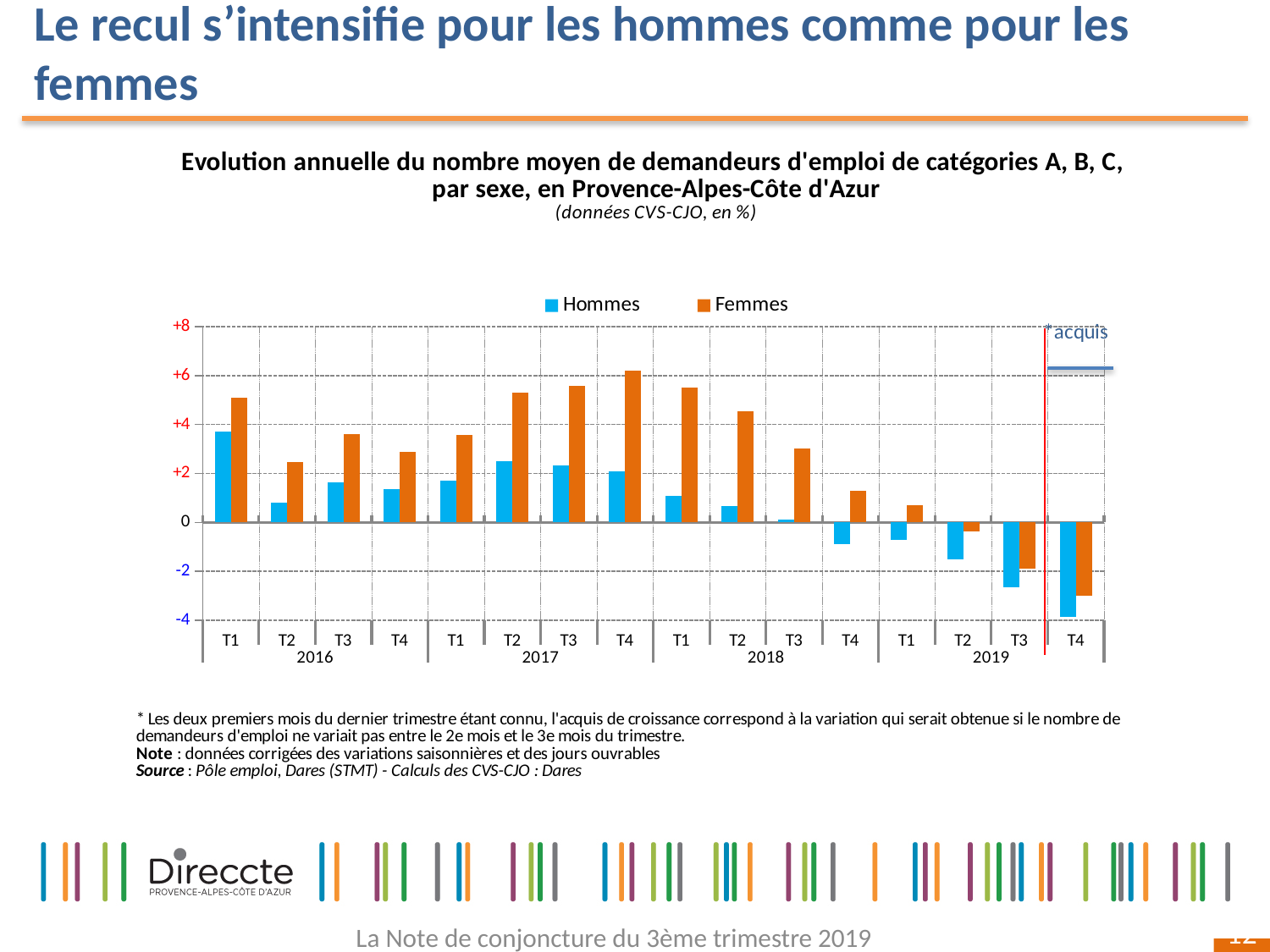
Is the Hommes value for T4 2019 greater or less than -2? less In which quarter is the Femmes value highest? T4 2017 Is the Femmes value for T2 2018 greater or less than +4? greater In which quarter is the Hommes value lowest? T4 2019 How many quarters are plotted along the x axis? 16 Do the Hommes values rise or fall from T1 2018 to T4 2019? fall How many series does the legend list? 2 Which series is shown in orange? Femmes In T1 2016, which series has the larger value, Hommes or Femmes? Femmes Is the Femmes value for T1 2016 greater or less than +4? greater In which quarter is the Hommes value highest? T1 2016 What kind of chart is shown on the slide? bar chart